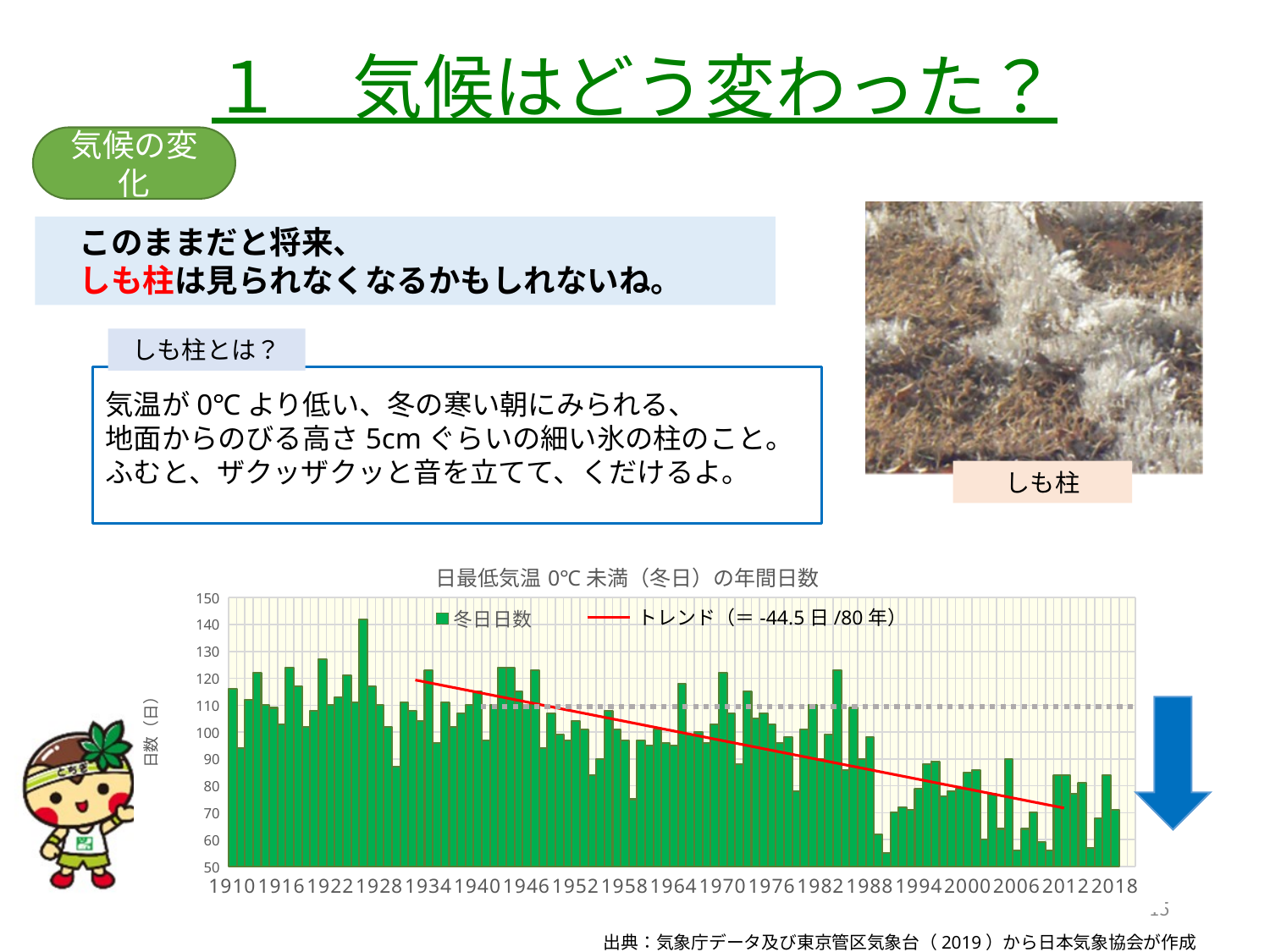
Which year has the larger number of winter days, 1970 or 2000? 1970 Is the value for 1910 greater or less than 110? greater What trend rate is printed in the chart's legend? -44.5日/80年 What is the title of the chart? 日最低気温0℃未満（冬日）の年間日数 How many entries does the chart's legend list? 2 Which year has the larger number of winter days, 1910 or 2018? 1910 Is the value for 1988 greater or less than 80? greater Is the value for 2018 greater or less than 80? less What kind of chart is shown on the slide? bar chart What is the lowest value shown on the vertical axis? 50 Do the number of winter days generally rise or fall from 1910 to 2018? fall